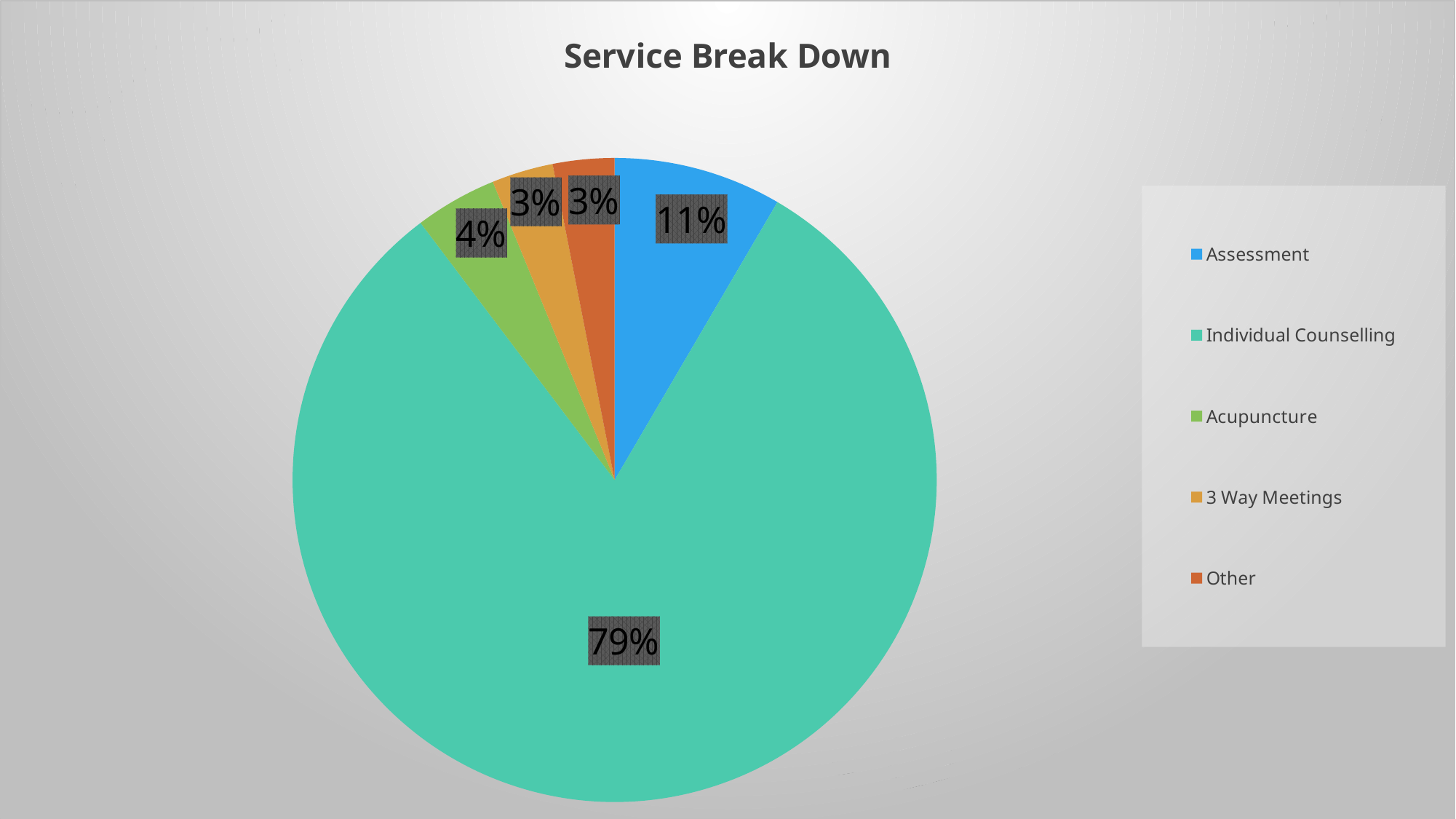
What type of chart is shown on the slide? pie chart Which colour represents Other in the legend? orange-red What share of the pie does Individual Counselling represent? 79% How many categories does the legend list? 5 What share of the pie does 3 Way Meetings represent? 3% What is the difference in percentage points between Assessment and Acupuncture? 7 What is the title of the chart? Service Break Down Which is larger, the share for Assessment or the share for Acupuncture? Assessment What is the difference in percentage points between Individual Counselling and Assessment? 68 What share of the pie does Assessment represent? 11% What share of the pie does Acupuncture represent? 4% Which category has the largest slice of the pie? Individual Counselling